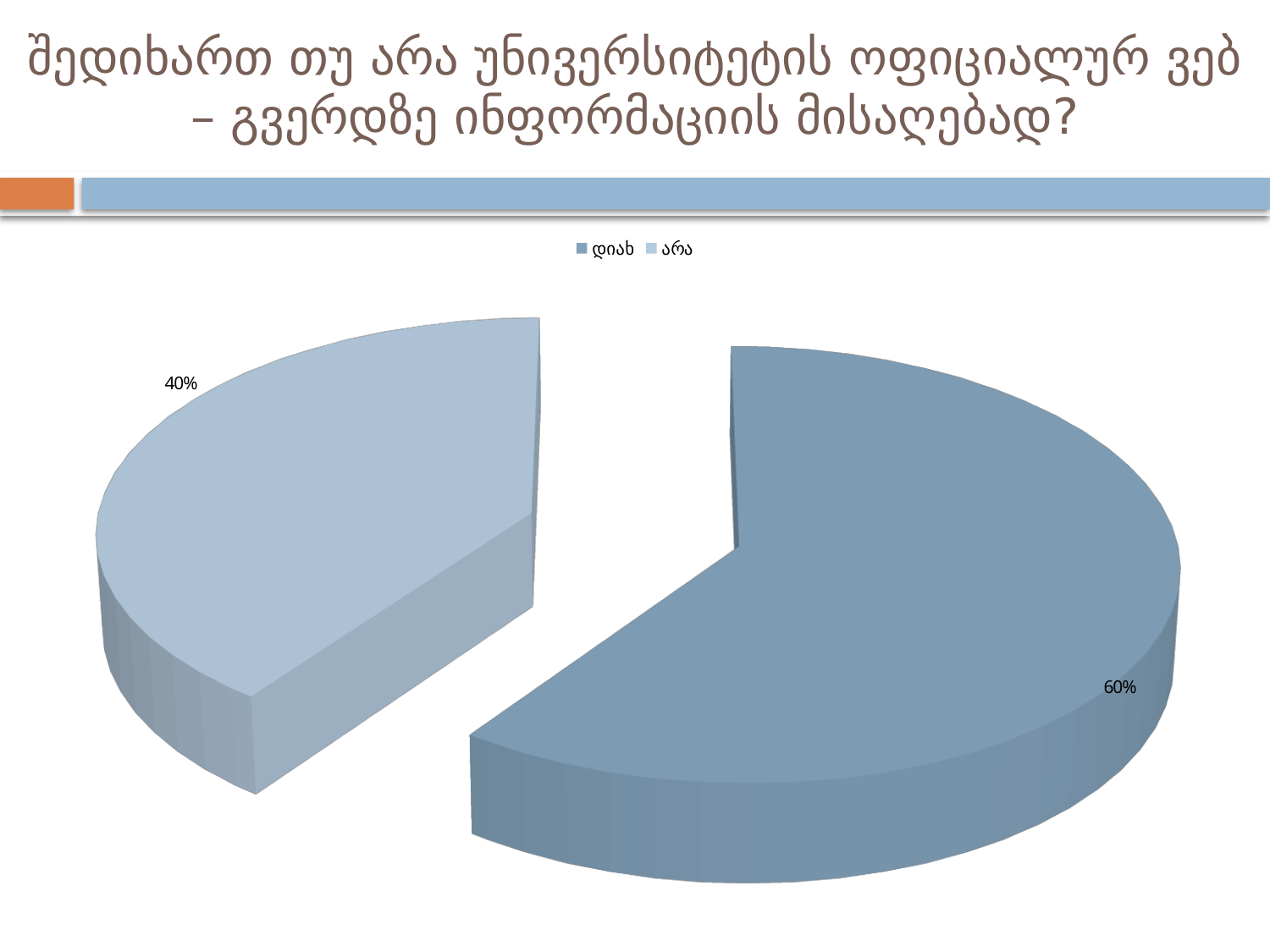
What share of the pie does the slice for დიახ represent? 60% Which category has the largest slice of the pie? დიახ What kind of chart is shown on the slide? pie chart Which category has the smallest slice of the pie? არა Which legend entry is shown in the lighter blue colour? არა Which legend entry is shown in the darker blue colour? დიახ What is the difference in percentage points between the დიახ slice and the არა slice? 20% How many slices does the pie chart have? 2 Which slice is larger, დიახ or არა? დიახ How many entries does the legend list? 2 What share of the pie does the slice for არა represent? 40%